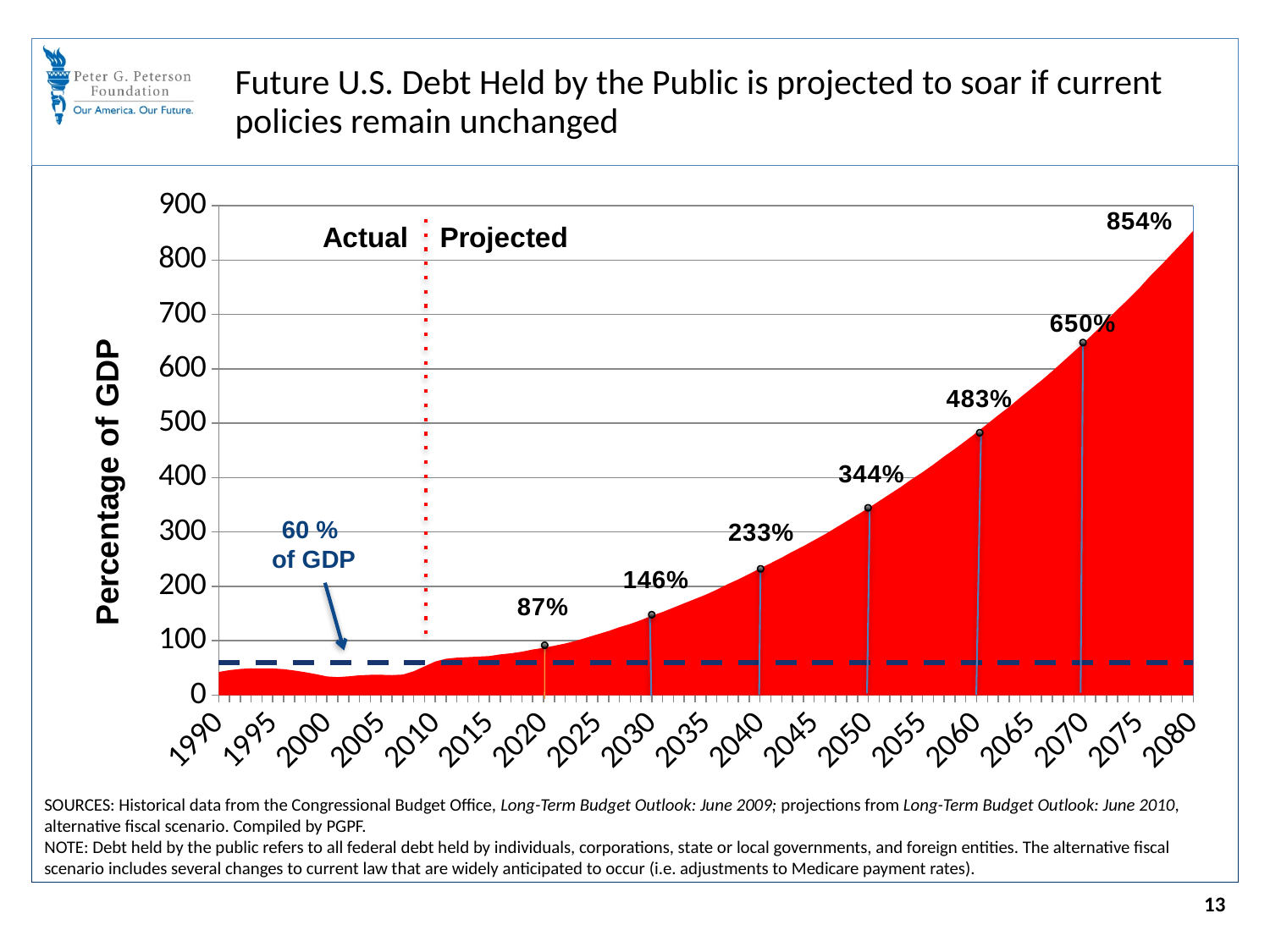
How many data points carry percentage labels on the chart? 7 Which is larger, the labeled value for 2030 or for 2050? 2050 What is the labeled value for 2040? 233% What is the difference between the labeled values for 2070 and 2050? 306% Which labeled year has the highest debt as a percentage of GDP? 2080 What level of GDP does the horizontal dashed line mark? 60 % of GDP Is the value for 2000 greater or less than 100? less What is the labeled value for 2020? 87% Which labeled year has the lowest debt as a percentage of GDP? 2020 Does debt as a percentage of GDP rise or fall from 2020 to 2080? rise What is the labeled value for 2060? 483% What is the projected debt held by the public as a percentage of GDP in 2080? 854%